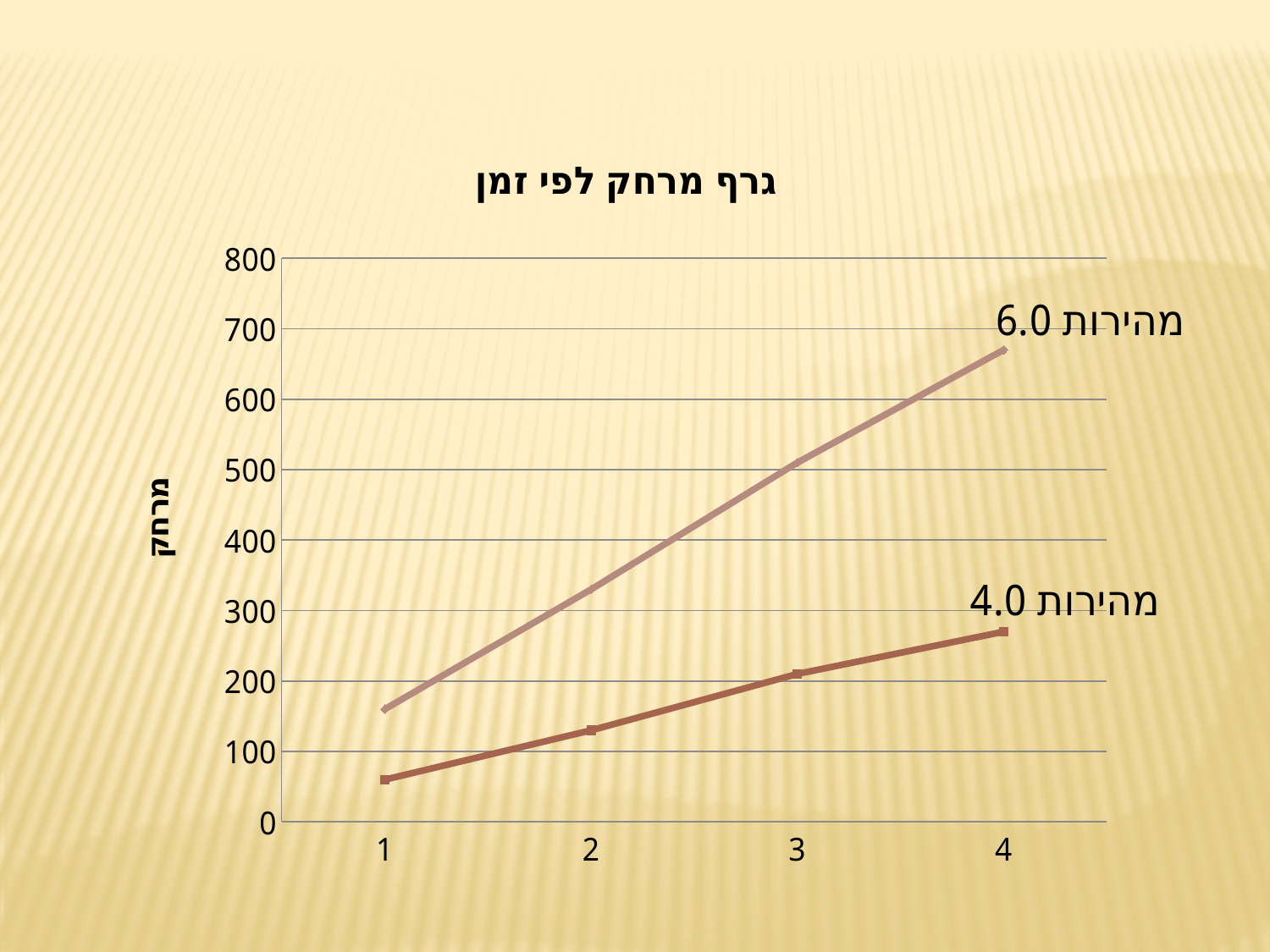
Is the value of מהירות 6.0 at x = 3 greater or less than 400? greater What is the label of the y axis? מרחק Is the value of מהירות 4.0 at x = 4 greater or less than 300? less At which x value does the series מהירות 4.0 reach its lowest value? 1 Is the value of מהירות 4.0 at x = 1 greater or less than 100? less What is the title of the chart? גרף מרחק לפי זמן At x = 4, which series has the larger value, מהירות 6.0 or מהירות 4.0? מהירות 6.0 How many series are plotted on the chart? 2 What kind of chart is shown on the slide? line chart How many points are plotted along the x axis for each series? 4 Do the values of the series מהירות 6.0 rise or fall as the x axis goes from 1 to 4? rise